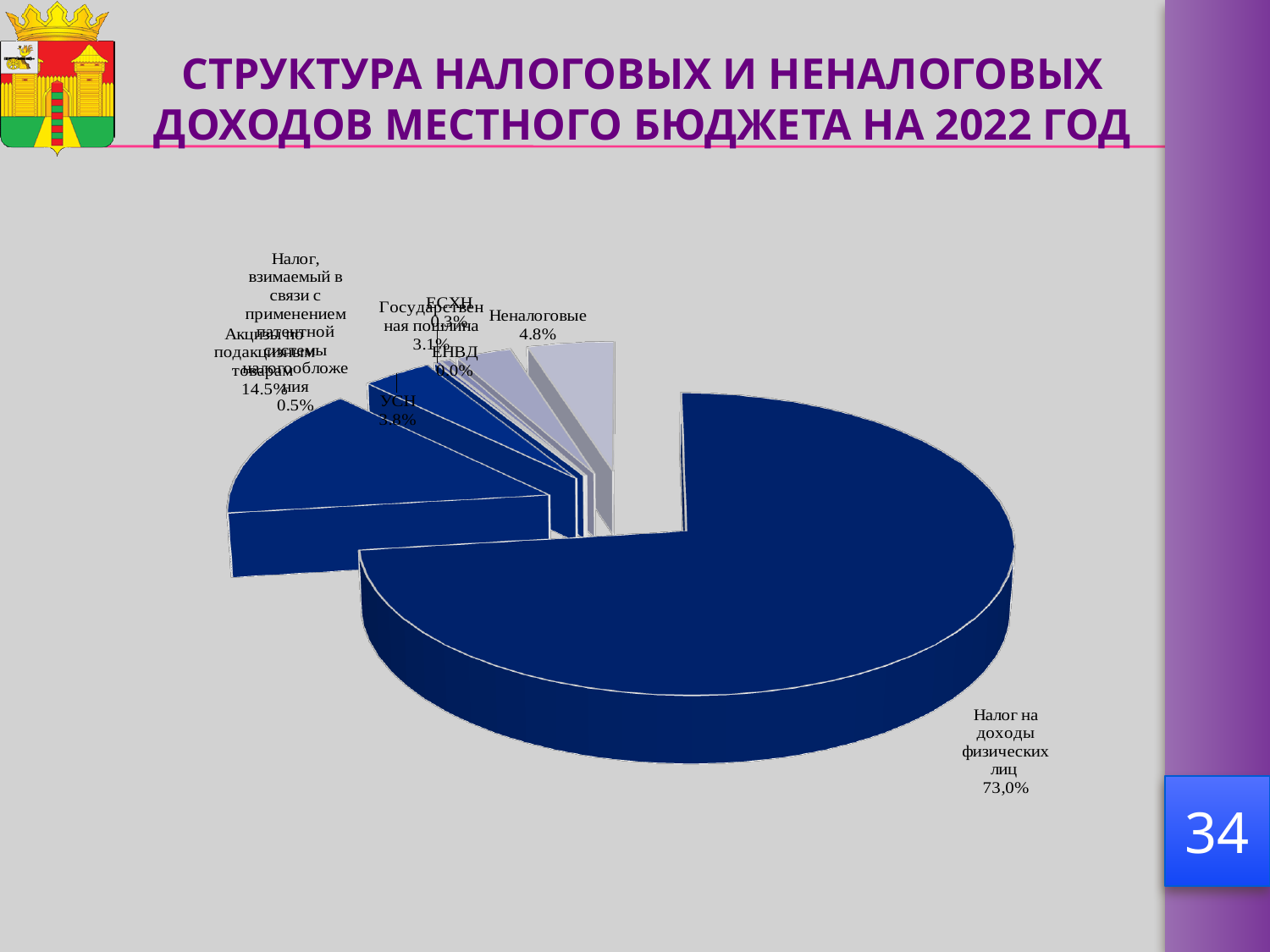
How many slices does the pie chart have? 8 What is the title of the slide containing the chart? СТРУКТУРА НАЛОГОВЫХ И НЕНАЛОГОВЫХ ДОХОДОВ МЕСТНОГО БЮДЖЕТА НА 2022 ГОД What share of the pie does "Налог на доходы физических лиц" have? 73,0% What is the difference between the shares of "Акцизы по подакцизным товарам" and "Неналоговые"? 9.7% What is the value shown for "Акцизы по подакцизным товарам"? 14.5% Which category has the largest slice of the pie? Налог на доходы физических лиц Which is larger, the share for "Акцизы по подакцизным товарам" or for "Неналоговые"? Акцизы по подакцизным товарам What is the value shown for "ЕНВД"? 0.0% What kind of chart is shown on the slide? pie chart Which category has the smallest value in the chart? ЕНВД What is the value shown for "Государственная пошлина"? 3.1% What is the value shown for "Неналоговые"? 4.8%